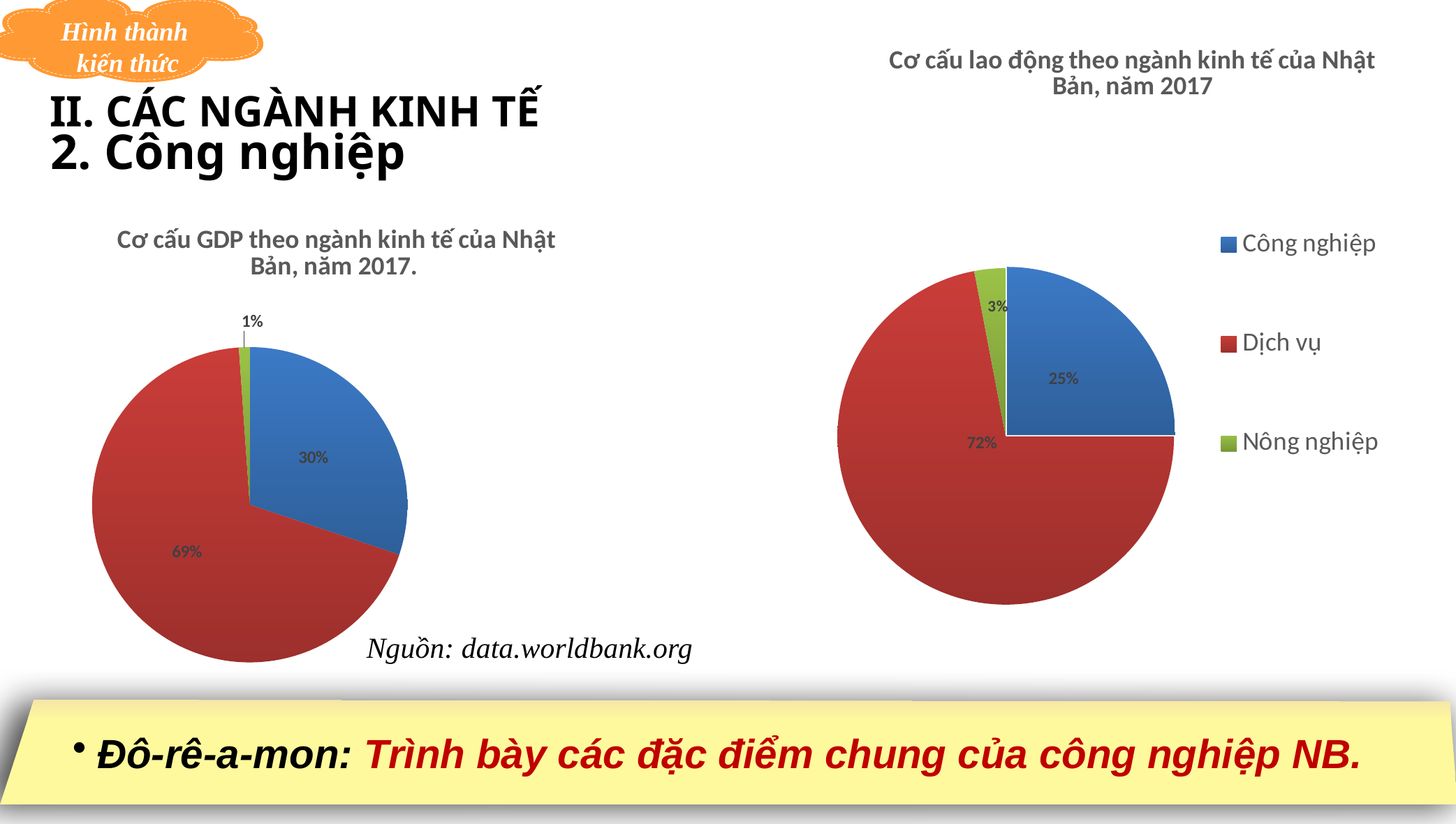
In the left chart (Cơ cấu GDP theo ngành kinh tế của Nhật Bản, năm 2017), what share does Công nghiệp have? 30% In the left chart (Cơ cấu GDP theo ngành kinh tế của Nhật Bản, năm 2017), what share does Nông nghiệp have? 1% In the right chart (Cơ cấu lao động theo ngành kinh tế của Nhật Bản, năm 2017), which sector has the largest share? Dịch vụ In the left chart (Cơ cấu GDP theo ngành kinh tế của Nhật Bản, năm 2017), which sector has the smallest share? Nông nghiệp Which is larger: the share of Công nghiệp in the left chart (GDP) or in the right chart (lao động)? Left chart (GDP), 30% In the right chart (Cơ cấu lao động theo ngành kinh tế của Nhật Bản, năm 2017), what share does Công nghiệp have? 25% In the left chart (Cơ cấu GDP theo ngành kinh tế của Nhật Bản, năm 2017), what share does Dịch vụ have? 69% What type of chart is the right chart (Cơ cấu lao động theo ngành kinh tế của Nhật Bản, năm 2017)? Pie chart How many slices does the left chart (Cơ cấu GDP theo ngành kinh tế của Nhật Bản, năm 2017) have? 3 In the right chart (Cơ cấu lao động theo ngành kinh tế của Nhật Bản, năm 2017), which sector is shown in red? Dịch vụ In the right chart (Cơ cấu lao động theo ngành kinh tế của Nhật Bản, năm 2017), what is the difference between the shares of Dịch vụ and Công nghiệp? 47% In the right chart (Cơ cấu lao động theo ngành kinh tế của Nhật Bản, năm 2017), what share does Nông nghiệp have? 3%